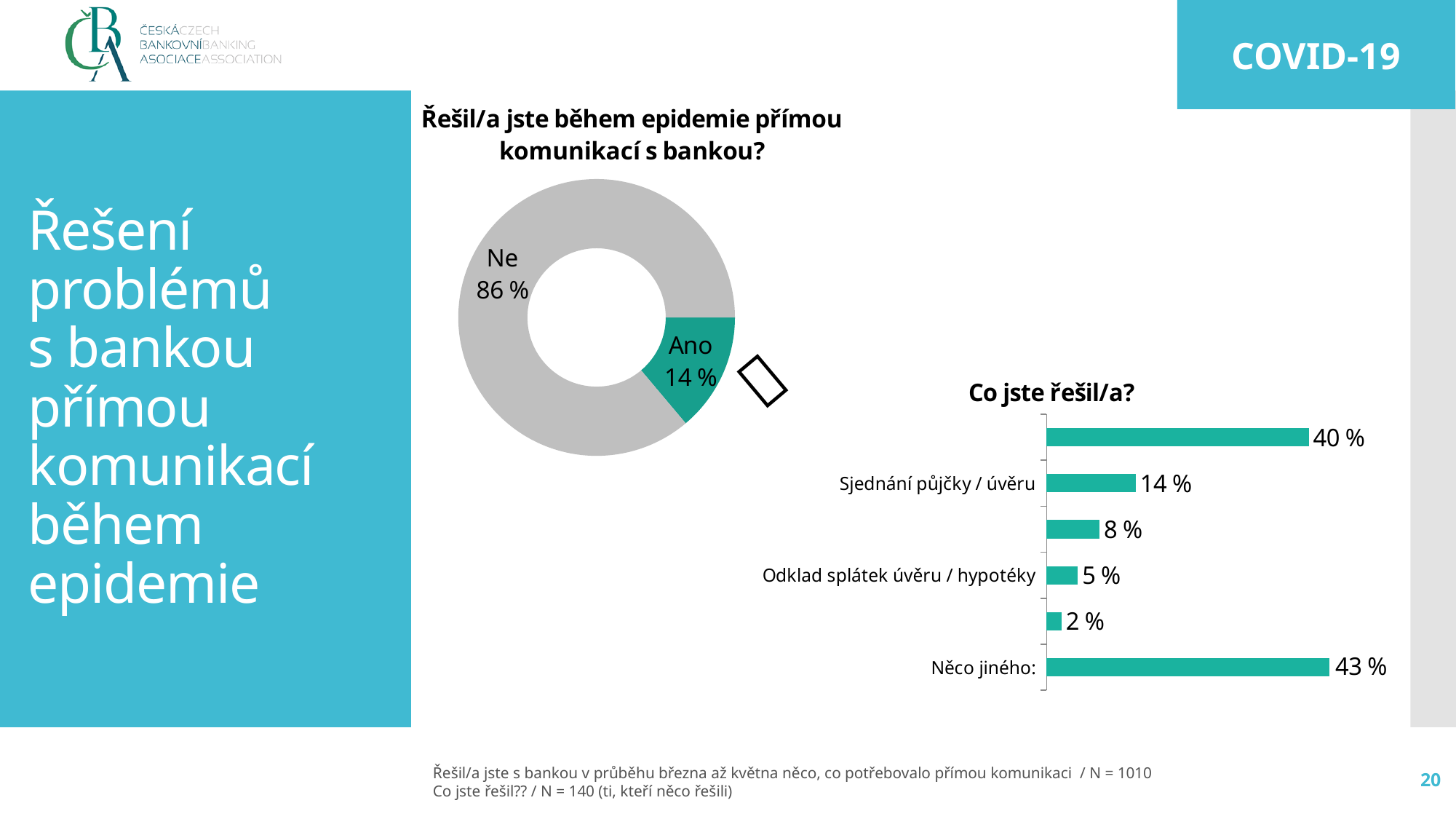
In the bar chart "Co jste řešil/a?", what is the value for "Sjednání půjčky / úvěru"? 14 % In the donut chart "Řešil/a jste během epidemie přímou komunikací s bankou?", which answer has the larger share? Ne What kind of chart is the one titled "Řešil/a jste během epidemie přímou komunikací s bankou?"? Donut (pie) chart In the bar chart "Co jste řešil/a?", what is the difference between "Něco jiného:" and "Sjednání půjčky / úvěru"? 29 % In the bar chart "Co jste řešil/a?", which is larger: "Sjednání půjčky / úvěru" or "Odklad splátek úvěru / hypotéky"? Sjednání půjčky / úvěru In the bar chart "Co jste řešil/a?", what is the value for "Odklad splátek úvěru / hypotéky"? 5 % How many bars are plotted in the bar chart "Co jste řešil/a?"? 6 In the donut chart "Řešil/a jste během epidemie přímou komunikací s bankou?", what is the difference between the "Ne" and "Ano" shares? 72 % In the donut chart "Řešil/a jste během epidemie přímou komunikací s bankou?", what share answered "Ano"? 14 % In the bar chart "Co jste řešil/a?", which category has the highest value? Něco jiného: In the donut chart "Řešil/a jste během epidemie přímou komunikací s bankou?", what share answered "Ne"? 86 % In the bar chart "Co jste řešil/a?", what is the value for "Něco jiného:"? 43 %